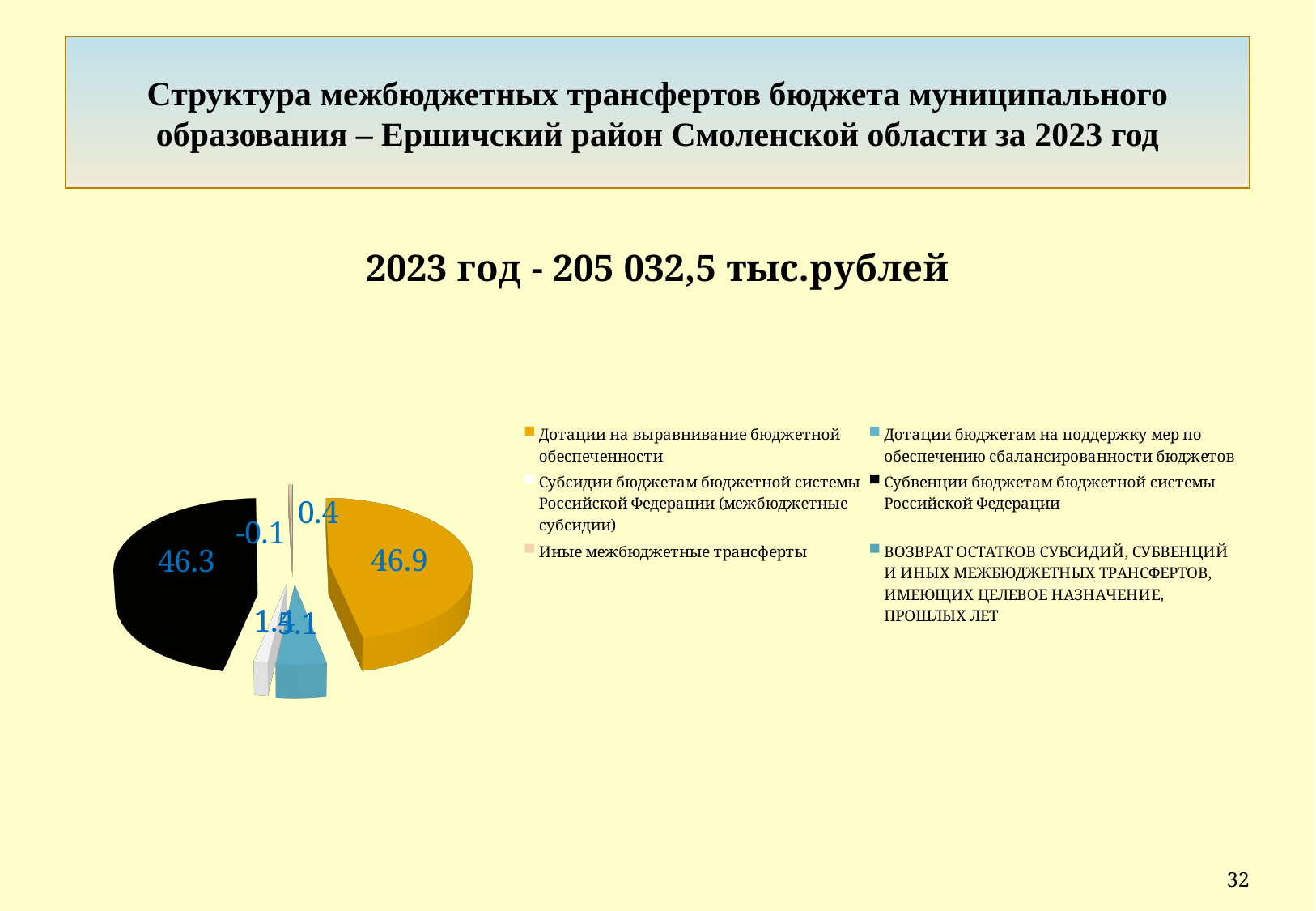
What value is labelled on the slice for Дотации на выравнивание бюджетной обеспеченности? 46.9 What is the difference between the values for Дотации на выравнивание бюджетной обеспеченности and Субвенции бюджетам бюджетной системы Российской Федерации? 0.6 What value is labelled on the slice for Субвенции бюджетам бюджетной системы Российской Федерации? 46.3 How many entries does the legend of the pie chart list? 6 Which category has the largest share of the pie? Дотации на выравнивание бюджетной обеспеченности Is the value for Дотации на выравнивание бюджетной обеспеченности greater or less than 40? greater What colour is the slice for Субвенции бюджетам бюджетной системы Российской Федерации? black What total amount for 2023 is stated above the chart? 205 032,5 тыс.рублей What is the smallest value labelled on the pie chart? -0.1 What kind of chart is shown on the slide? pie chart Which is larger: the value for Дотации на выравнивание бюджетной обеспеченности or for Субвенции бюджетам бюджетной системы Российской Федерации? Дотации на выравнивание бюджетной обеспеченности